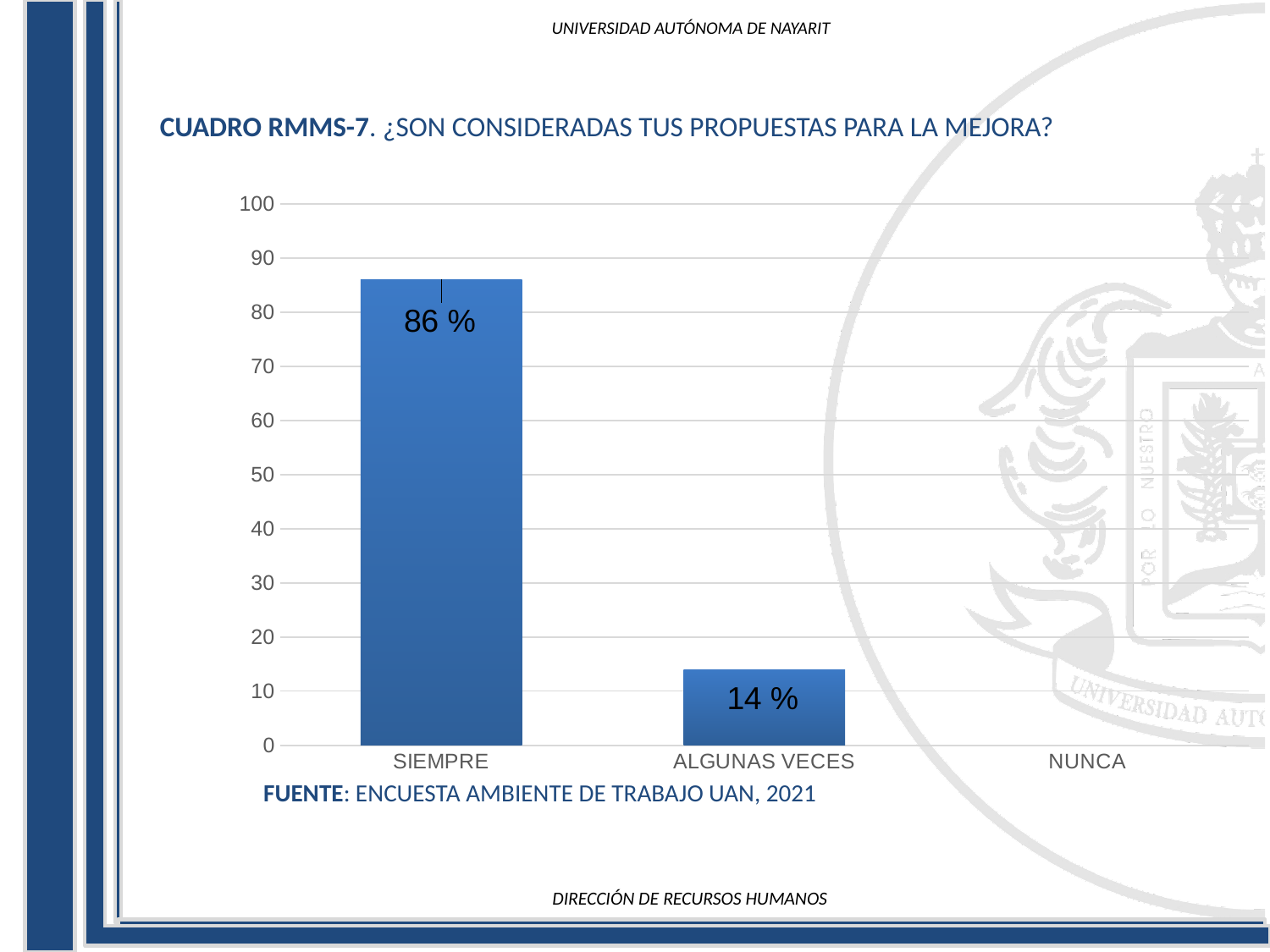
What source is cited below the chart? ENCUESTA AMBIENTE DE TRABAJO UAN, 2021 Is the value for SIEMPRE greater or less than 80? greater Which is larger, the value for SIEMPRE or the value for ALGUNAS VECES? SIEMPRE What is the value for SIEMPRE? 86 % How many categories are shown on the x axis? 3 What question does the chart title ask? ¿SON CONSIDERADAS TUS PROPUESTAS PARA LA MEJORA? What kind of chart is shown on the slide? bar chart Is the value for ALGUNAS VECES greater or less than 20? less What is the difference between the values for SIEMPRE and ALGUNAS VECES? 72 % What is the value for ALGUNAS VECES? 14 % Which category has the highest value? SIEMPRE